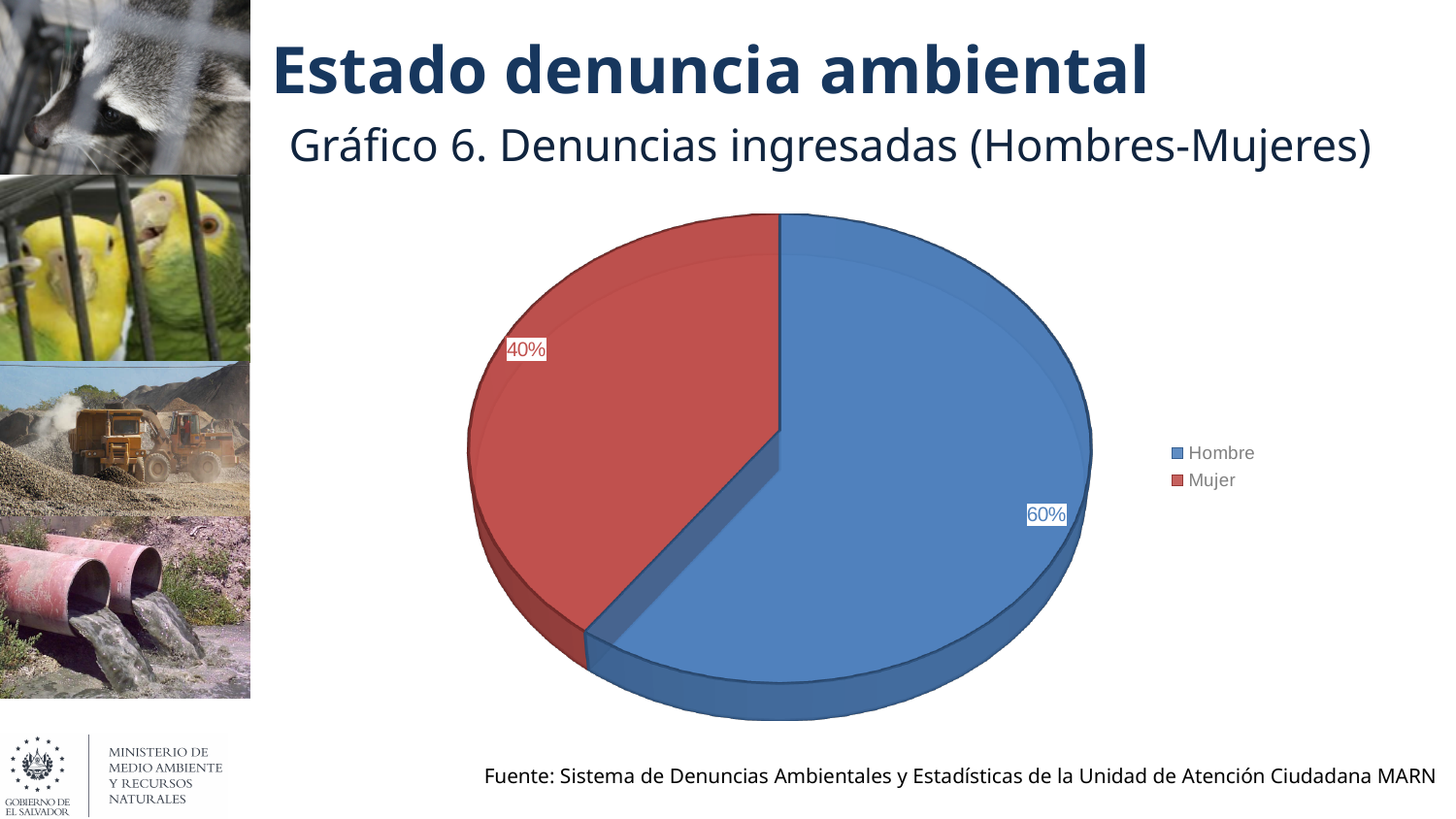
Which category has the smallest slice of the pie? Mujer What is the title of the chart? Gráfico 6. Denuncias ingresadas (Hombres-Mujeres) What is the difference in percentage points between the Hombre and Mujer slices? 20 percentage points How many slices does the pie chart have? 2 What colour is the Mujer slice? Red Which category has the largest slice of the pie? Hombre What share of the pie does Hombre account for? 60% How many entries does the legend list? 2 What share of the pie does Mujer account for? 40% Which slice is larger, Hombre or Mujer? Hombre What kind of chart is shown on the slide? Pie chart